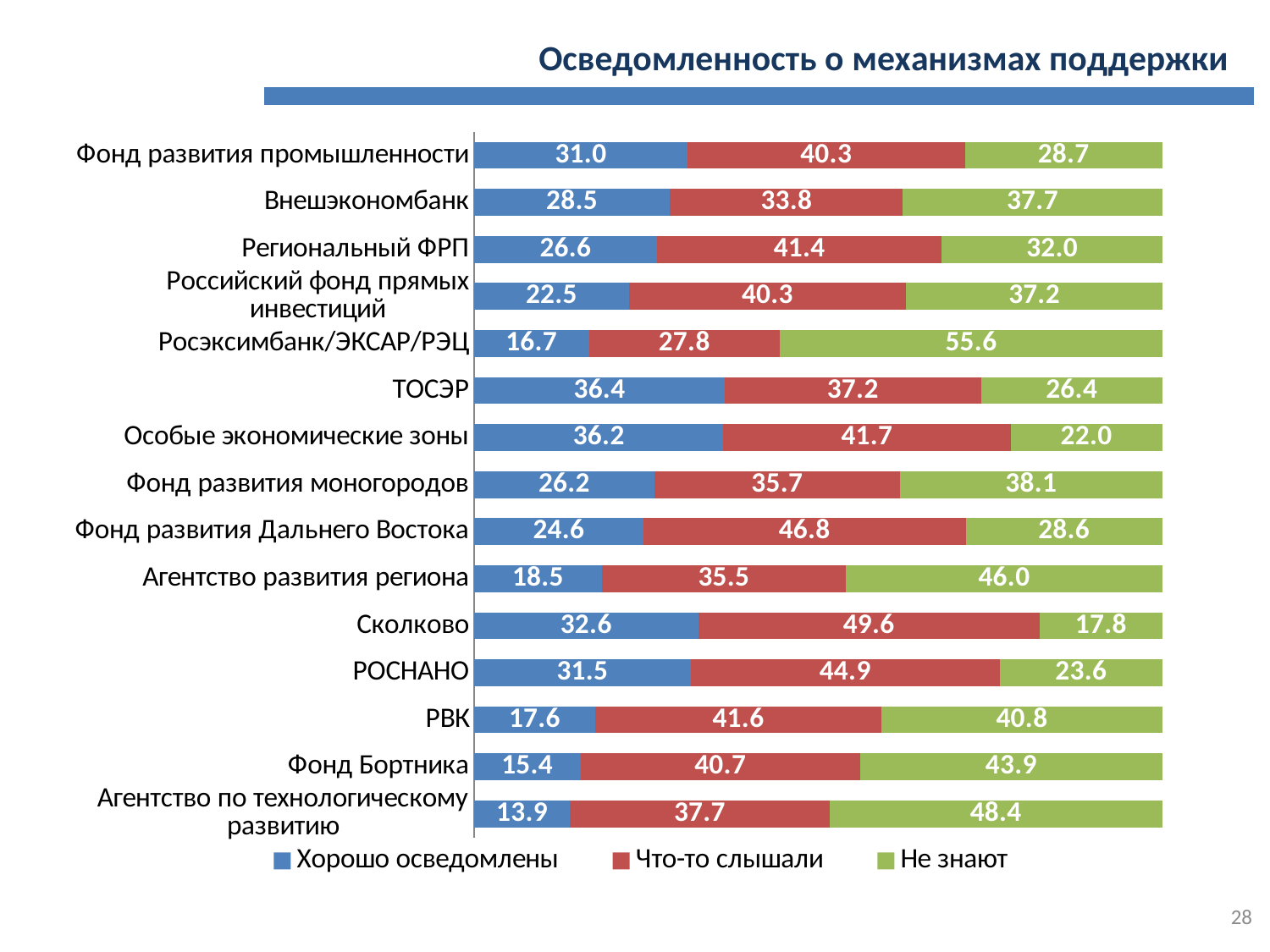
How many series does the legend list? 3 Which category has the highest value for "Не знают"? Росэксимбанк/ЭКСАР/РЭЦ What is the title of the slide? Осведомленность о механизмах поддержки Which category has the lowest value for "Хорошо осведомлены"? Агентство по технологическому развитию Which category has the highest value for "Что-то слышали"? Сколково What is the difference between the "Не знают" and "Хорошо осведомлены" values for Росэксимбанк/ЭКСАР/РЭЦ? 38.9 What is the value of "Хорошо осведомлены" for Сколково? 32.6 Which is larger: the "Хорошо осведомлены" value for РОСНАНО or for РВК? РОСНАНО What kind of chart is shown on the slide? Stacked bar chart What is the value of "Что-то слышали" for Фонд развития Дальнего Востока? 46.8 How many categories are shown in the chart? 15 What is the value of "Не знают" for Росэксимбанк/ЭКСАР/РЭЦ? 55.6